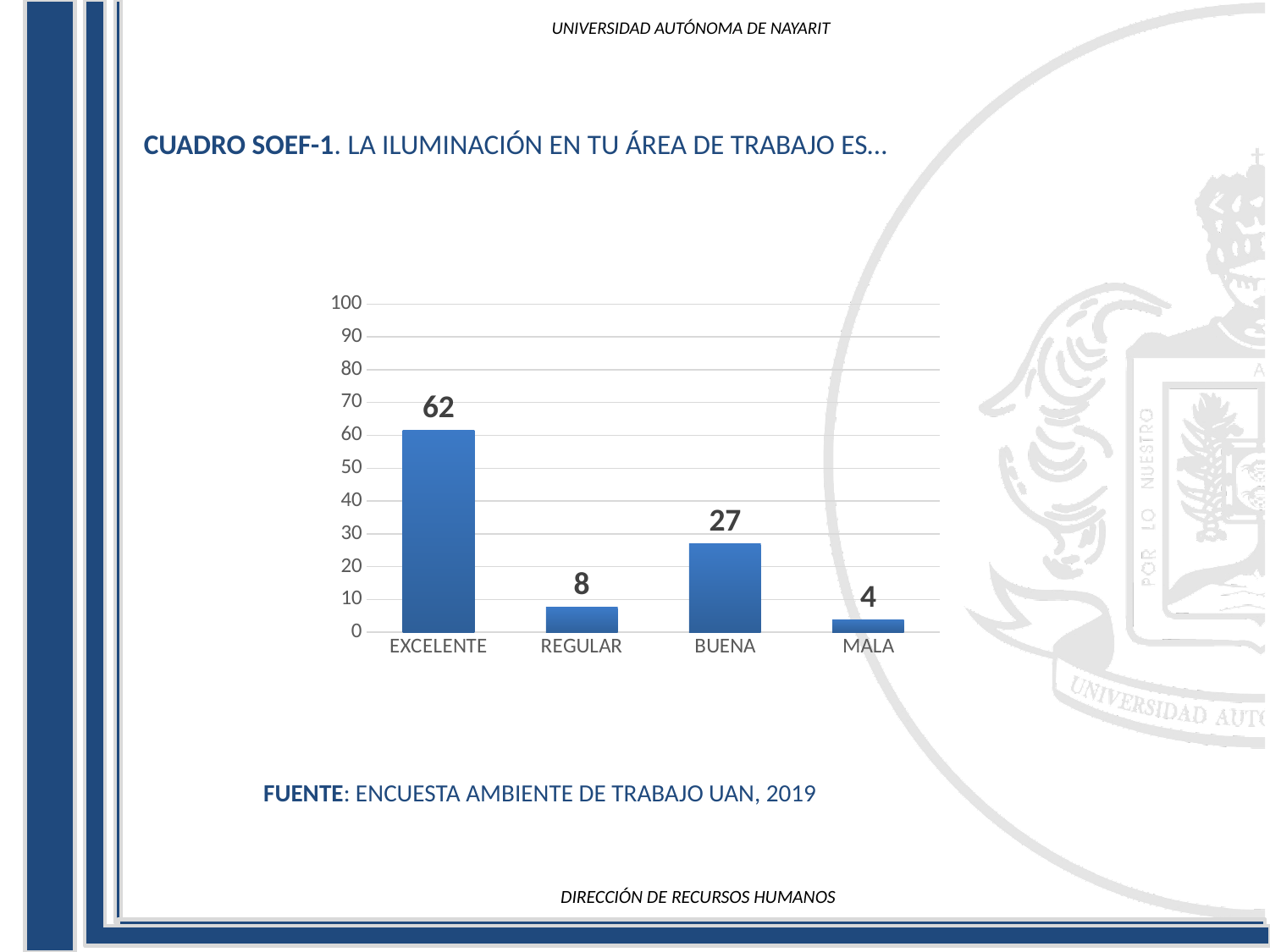
Is the value for EXCELENTE greater or less than 50? greater Which category has the lowest value? MALA What is the value for REGULAR? 8 How many categories are shown on the x axis? 4 Which is larger, the value for BUENA or the value for REGULAR? BUENA What is the value for MALA? 4 What is the value for EXCELENTE? 62 What is the value for BUENA? 27 What kind of chart is shown on the slide? bar chart What is the difference between the values for EXCELENTE and BUENA? 35 Which category has the highest value? EXCELENTE What is the difference between the values for REGULAR and MALA? 4